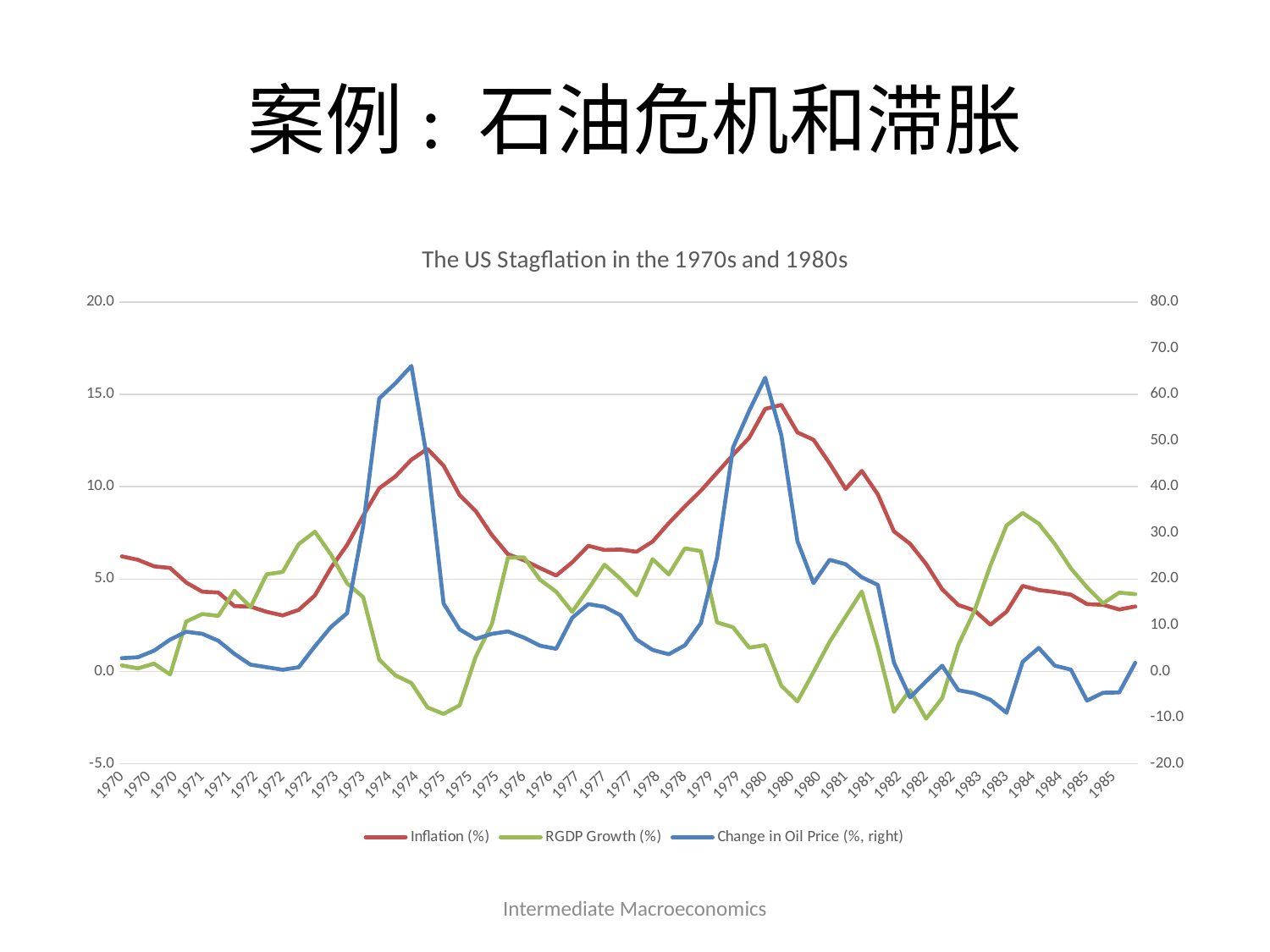
Is the lowest RGDP Growth (%) value around 1982 greater or less than 0.0? less How many series does the legend list? 3 Around 1980, which series is higher on the left axis, Inflation (%) or RGDP Growth (%)? Inflation (%) Is the Inflation (%) value at the start of 1970 greater or less than 5.0? greater Which series is plotted against the right-hand axis? Change in Oil Price (%, right) Does Inflation (%) rise or fall from 1980 to 1985? fall What kind of chart is shown on the slide? line chart Is the peak of RGDP Growth (%) around 1984 greater or less than 5.0? greater Does Inflation (%) rise or fall from 1976 to 1980? rise What is the title of the chart? The US Stagflation in the 1970s and 1980s